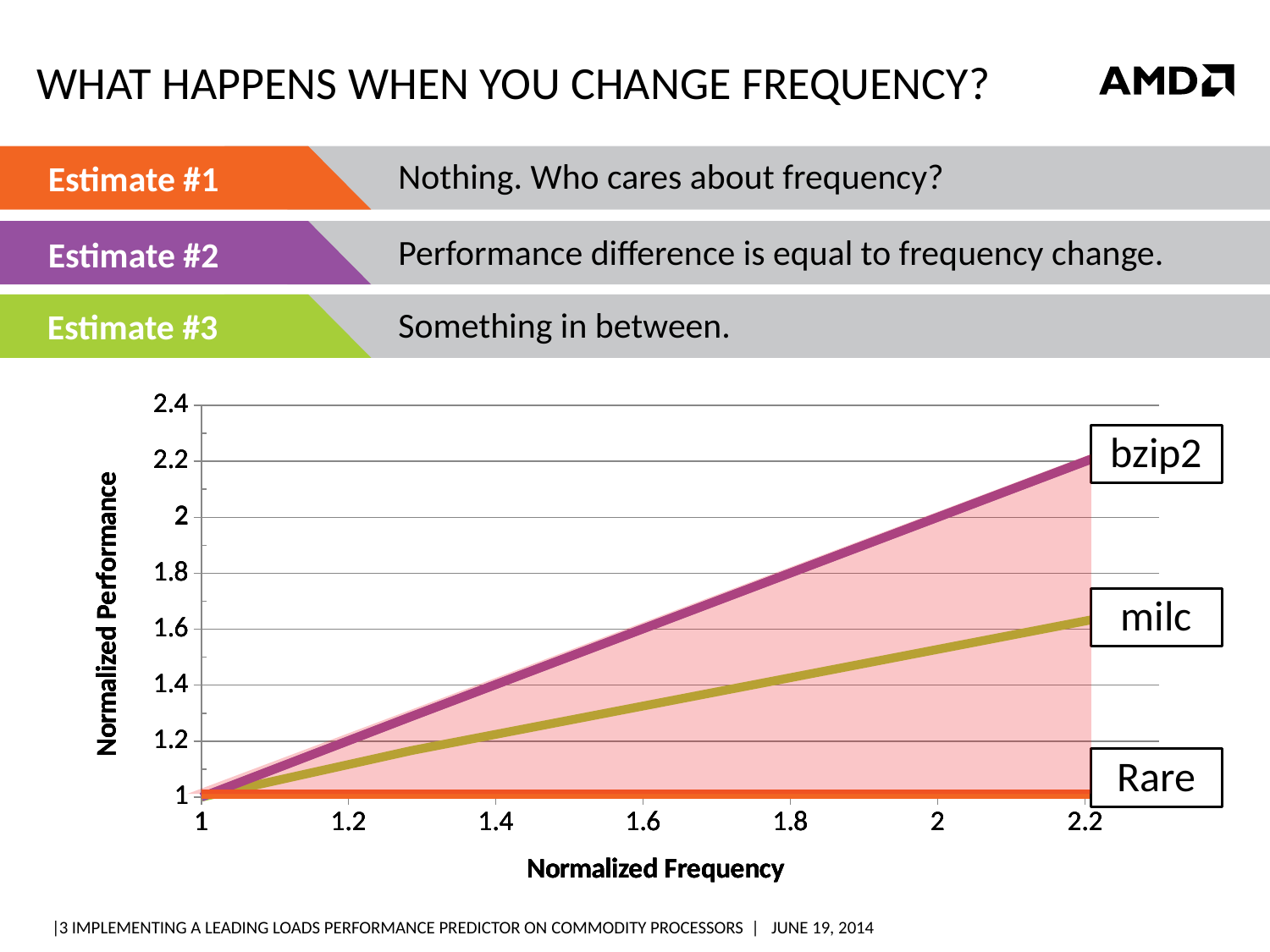
What is the title of the y axis of the chart? Normalized Performance Is the normalized performance of milc at normalized frequency 2 greater or less than 1.4? greater Which line reaches the highest normalized performance at the right end of the chart? bzip2 Does the Rare line rise, fall, or stay flat as normalized frequency increases? stay flat What kind of chart is shown on the slide? line chart Which line is higher at normalized frequency 1.8, bzip2 or milc? bzip2 How many lines are plotted on the chart? 3 What is the title of the x axis of the chart? Normalized Frequency Which line has the lowest normalized performance at the right end of the chart? Rare Does the bzip2 line rise, fall, or stay flat as normalized frequency increases? rise Is the normalized performance of bzip2 at normalized frequency 2.2 greater or less than 2? greater Is the normalized performance of milc at normalized frequency 2.2 greater or less than 1.8? less